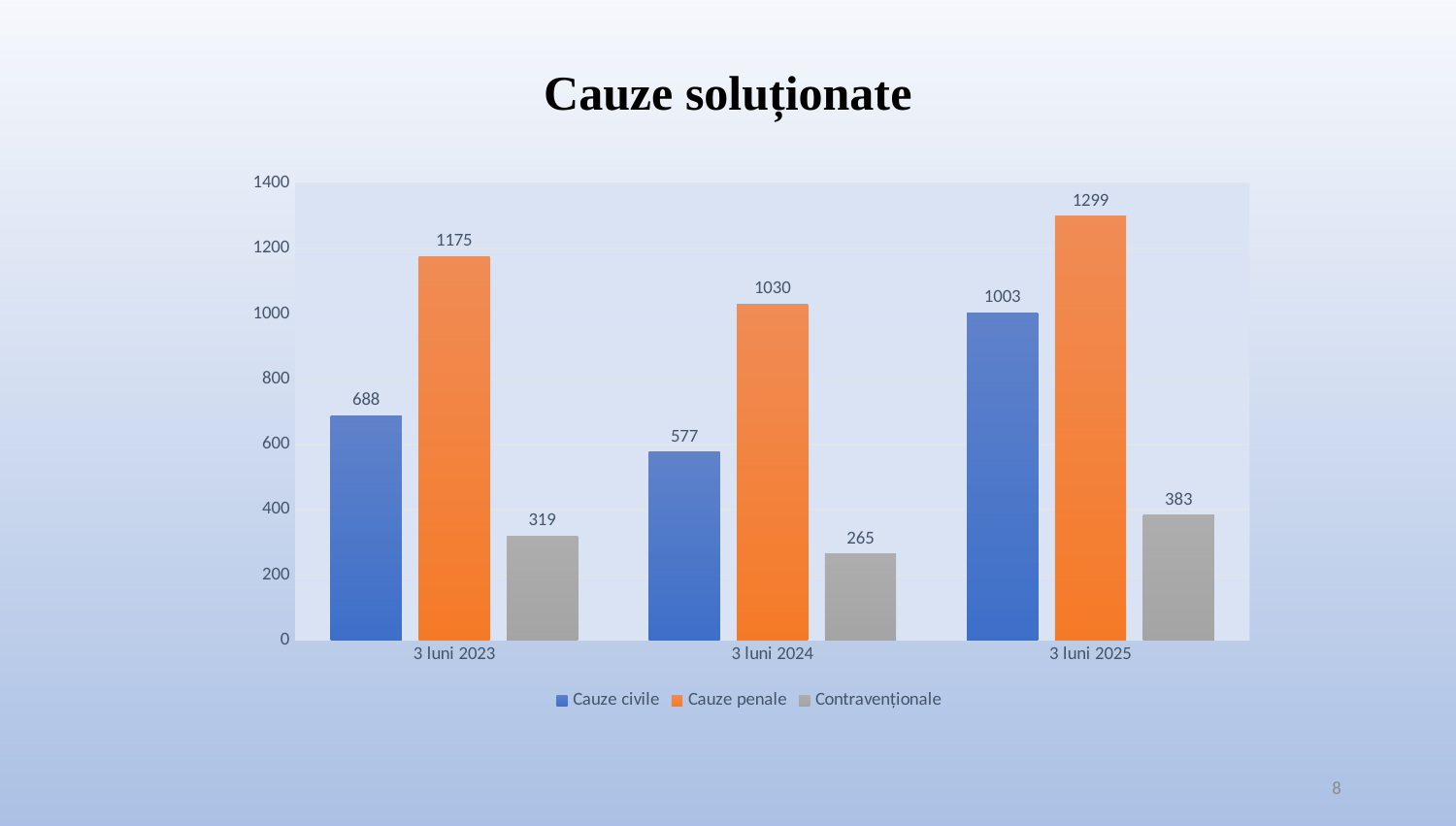
How many series does the legend list? 3 What is the title of the chart? Cauze soluționate What is the value for Contravenționale in 3 luni 2024? 265 What is the value for Cauze civile in 3 luni 2023? 688 How many periods are shown on the x axis? 3 What kind of chart is shown on the slide? Bar chart What is the value for Cauze penale in 3 luni 2025? 1299 What is the difference between Cauze civile and Contravenționale in 3 luni 2023? 369 In which period is the value for Cauze penale highest? 3 luni 2025 Which is larger: Cauze civile in 3 luni 2025 or Cauze penale in 3 luni 2024? Cauze penale in 3 luni 2024 What is the difference between Cauze penale in 3 luni 2025 and 3 luni 2024? 269 In which period is the value for Cauze civile lowest? 3 luni 2024